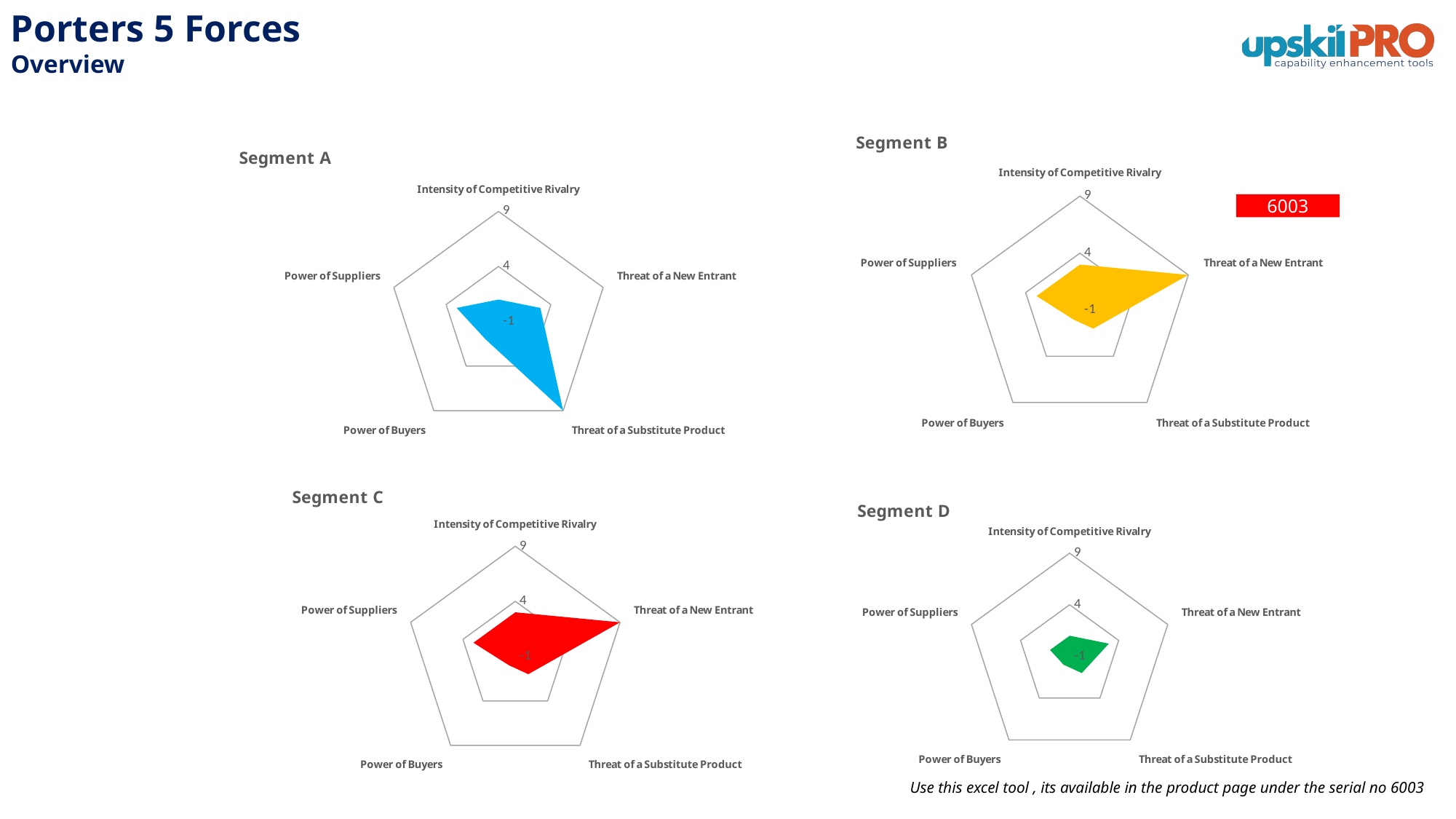
In the Segment C chart, which is larger: Threat of a New Entrant or Threat of a Substitute Product? Threat of a New Entrant In the Segment A chart, is the value for Intensity of Competitive Rivalry greater or less than 4? less In the Segment A chart, which force has the highest value? Threat of a Substitute Product In the Segment B chart, which is larger: Threat of a New Entrant or Power of Buyers? Threat of a New Entrant What colour is the plotted area in the Segment C chart? Red In the Segment A chart, is the value for Threat of a Substitute Product greater or less than 4? greater In the Segment B chart, is the value for Threat of a New Entrant greater or less than 4? greater In the Segment B chart, which force has the highest value? Threat of a New Entrant In the Segment C chart, which force has the highest value? Threat of a New Entrant How many categories (forces) are plotted on the Segment B chart? 5 What kind of chart is used for Segment A? Radar chart